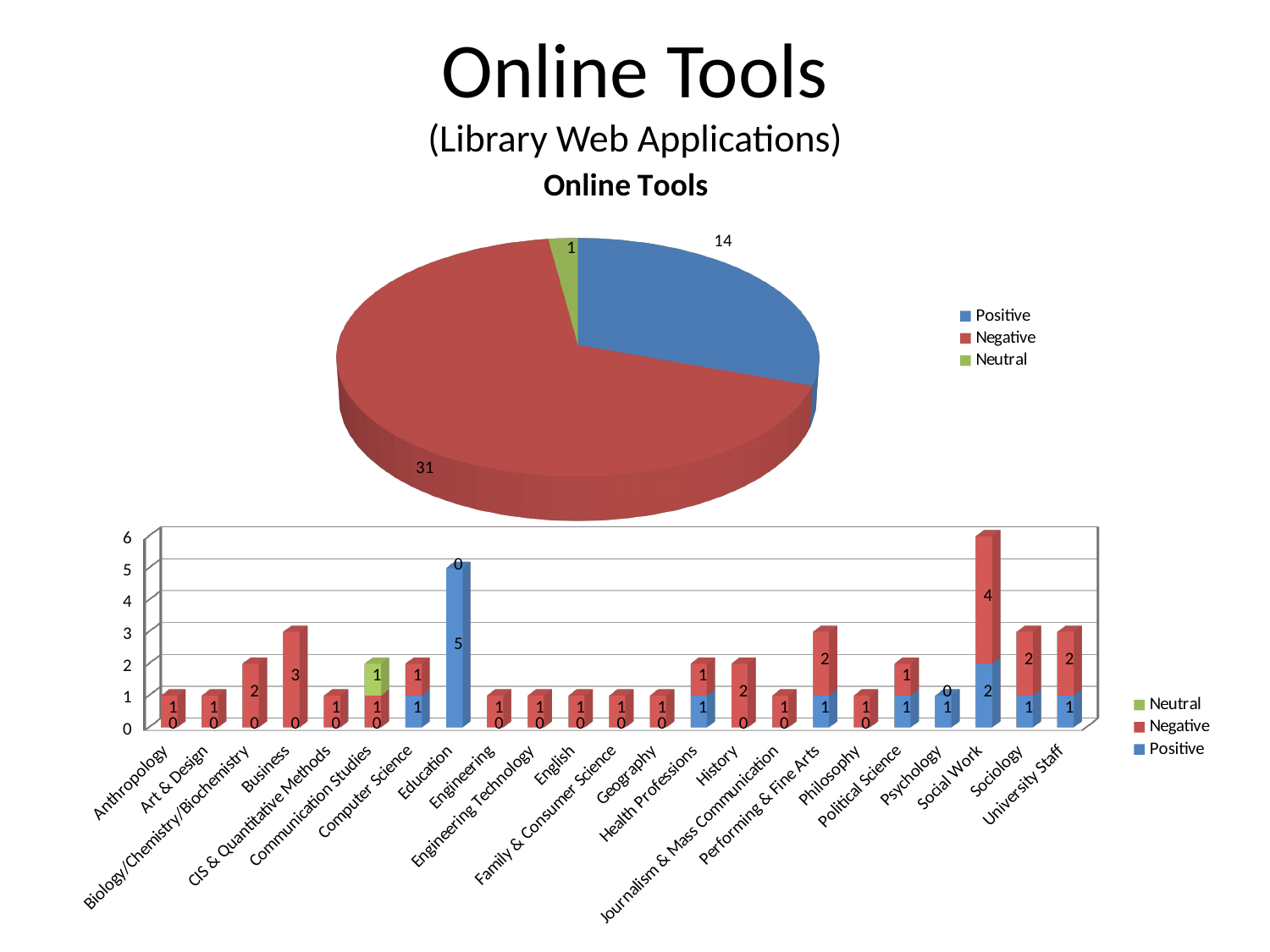
In the lower bar chart, what is the Positive value for Education? 5 In the lower bar chart, which has the larger Negative value, Business or History? Business In the pie chart titled "Online Tools", which category has the smallest slice? Neutral In the pie chart titled "Online Tools", what is the total of all three slices? 46 In the pie chart titled "Online Tools", which category has the largest slice? Negative In the lower bar chart, what is the Negative value for Social Work? 4 How many categories are shown on the x axis of the lower bar chart? 23 In the pie chart titled "Online Tools", what is the value for Negative? 31 In the pie chart titled "Online Tools", how much larger is the Negative value than the Positive value? 17 In the lower bar chart, what is the total height of the stacked bar for Social Work? 6 How many series does the legend of the lower bar chart list? 3 What kind of chart is the upper chart titled "Online Tools"? pie chart